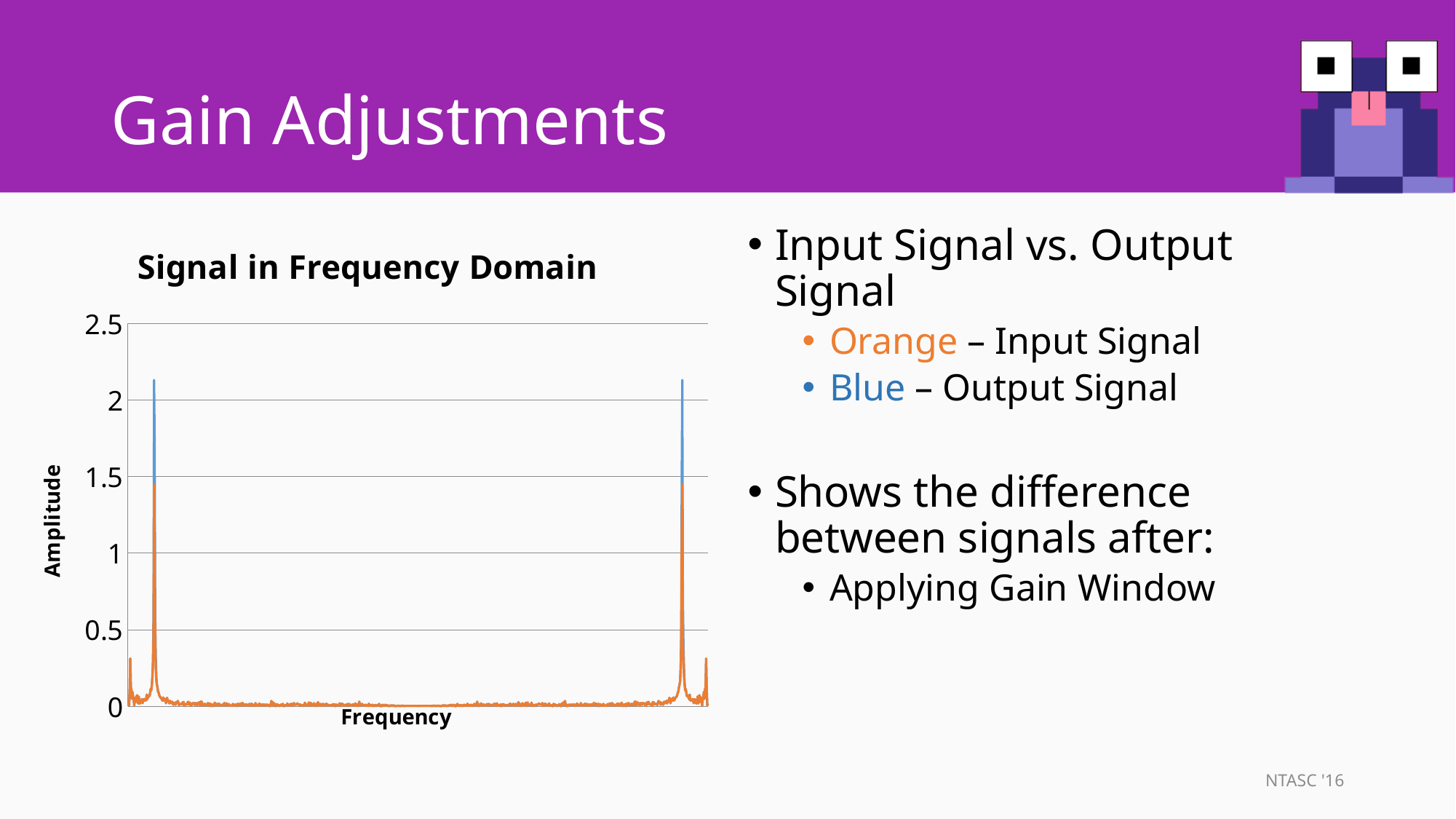
What is the highest value shown on the Amplitude axis? 2.5 Is the peak amplitude of the orange (Input Signal) line greater or less than 1? greater Is the peak amplitude of the blue (Output Signal) line greater or less than 1.5? greater What is the label of the vertical axis of the chart? Amplitude How many signal series are plotted in the chart? 2 Which signal reaches a higher peak amplitude, the blue Output Signal or the orange Input Signal? Blue Output Signal Is the peak amplitude of the blue (Output Signal) line greater or less than 2? greater What kind of chart is shown on the slide? line chart What is the title of the chart? Signal in Frequency Domain